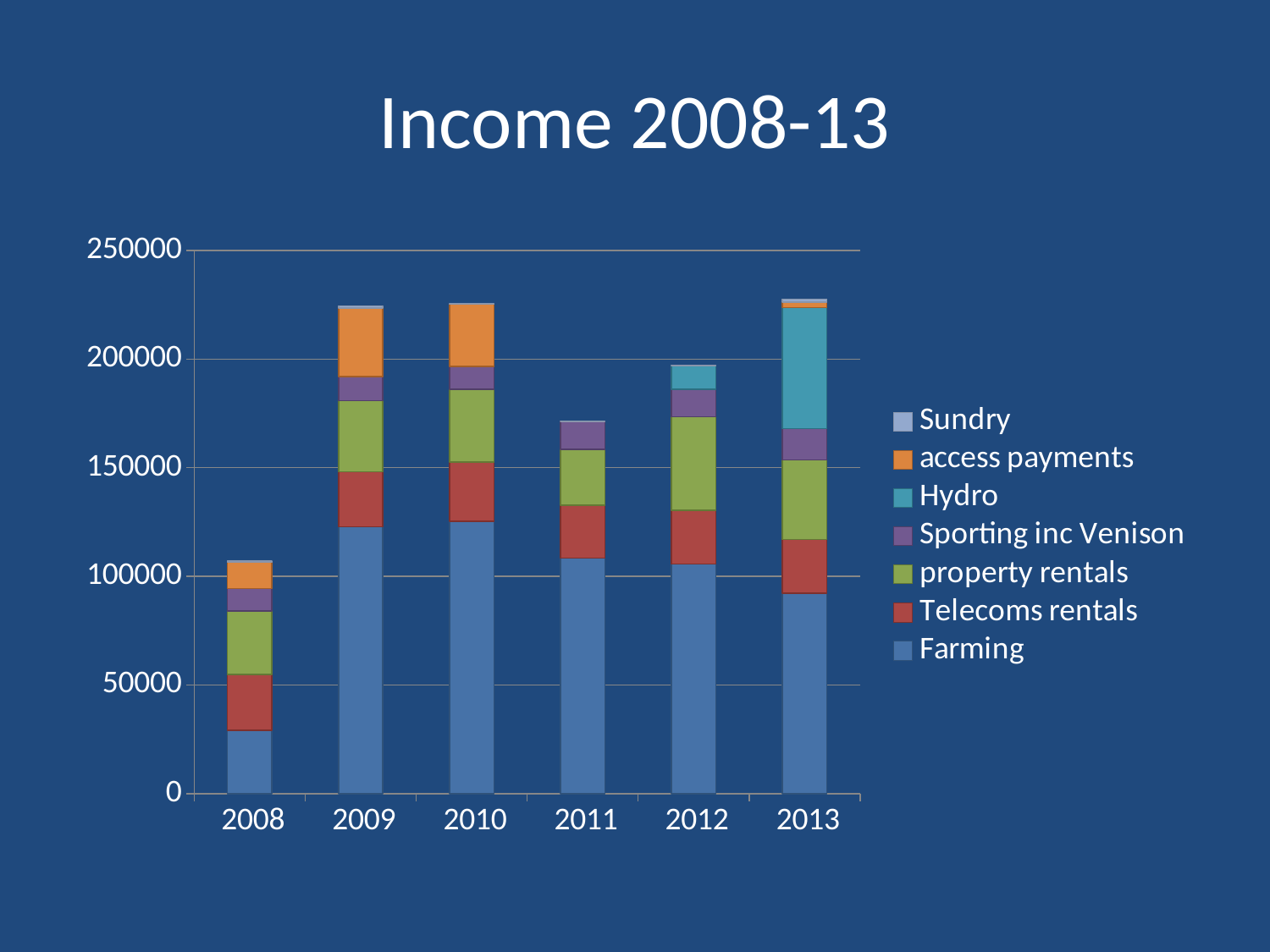
Which series is shown in orange in the legend? access payments How many years are shown on the x axis of the chart? 6 Which year has the larger total income bar, 2011 or 2012? 2012 Is the total income bar for 2008 greater or less than 150000? less What kind of chart is shown on the slide? Stacked bar chart Which year has the lowest total income bar? 2008 How many series does the legend list? 7 Is the total income bar for 2011 greater or less than 200000? less Is the Farming segment for 2008 greater or less than 50000? less What is the title of the chart? Income 2008-13